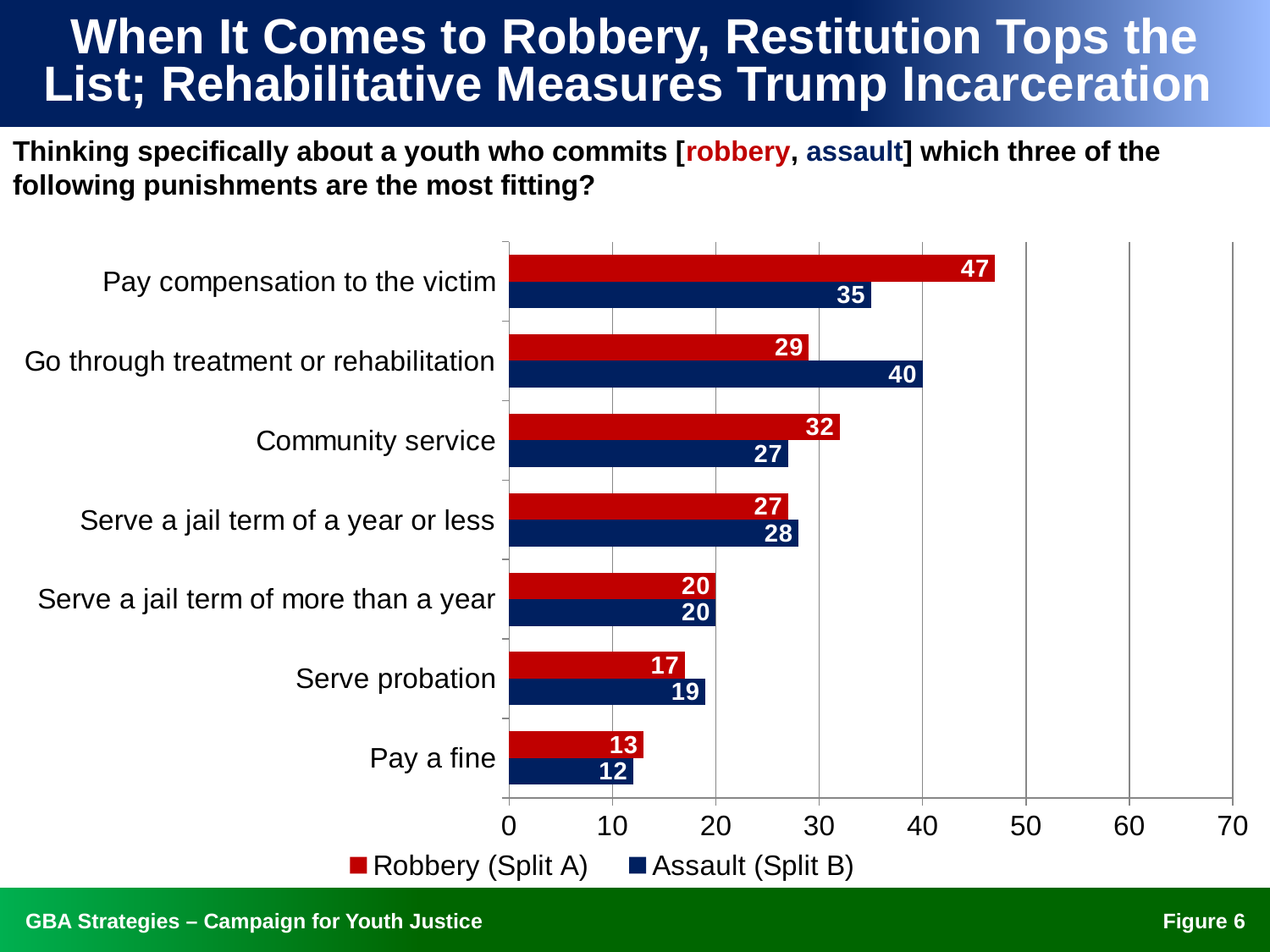
What is the difference between the Robbery (Split A) and Assault (Split B) values for 'Pay compensation to the victim'? 12 Which category has the highest Robbery (Split A) value? Pay compensation to the victim What kind of chart is shown on the slide? bar chart How many categories are shown on the chart? 7 How many series does the legend list? 2 What is the Assault (Split B) value for 'Go through treatment or rehabilitation'? 40 Is the Robbery (Split A) value for 'Pay compensation to the victim' greater or less than 40? greater What is the difference between the Assault (Split B) and Robbery (Split A) values for 'Go through treatment or rehabilitation'? 11 What is the Robbery (Split A) value for 'Pay compensation to the victim'? 47 Which category has the lowest Assault (Split B) value? Pay a fine For 'Community service', which is larger: the Robbery (Split A) value or the Assault (Split B) value? Robbery (Split A) What is the Assault (Split B) value for 'Serve probation'? 19